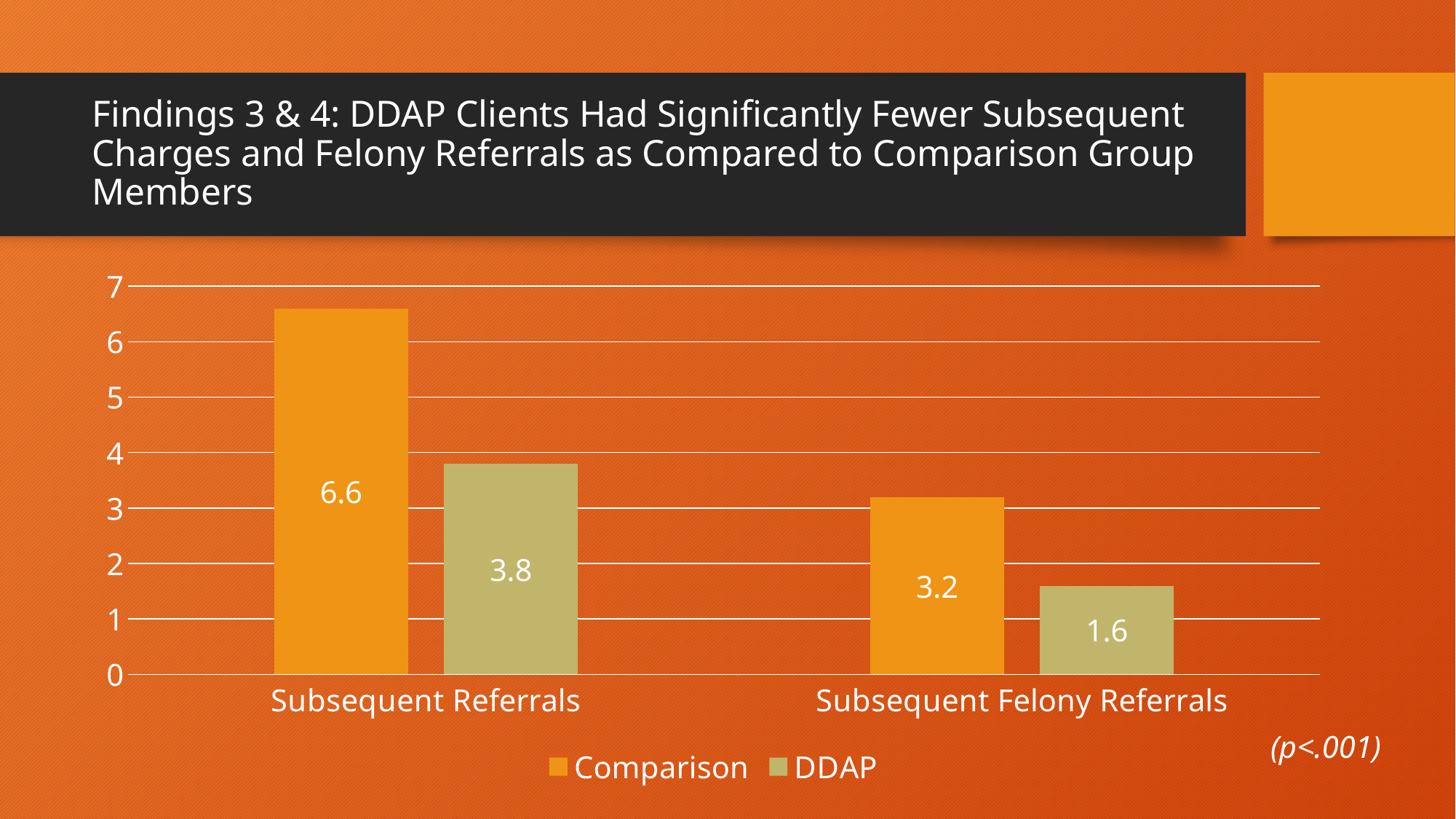
Which bar has the highest value on the chart? Comparison, Subsequent Referrals What is the Comparison group's value for Subsequent Referrals? 6.6 Which bar has the lowest value on the chart? DDAP, Subsequent Felony Referrals What kind of chart is shown on the slide? Bar chart What is the difference between the Comparison and DDAP values for Subsequent Felony Referrals? 1.6 What is the DDAP value for Subsequent Felony Referrals? 1.6 For Subsequent Felony Referrals, which group has the larger value, Comparison or DDAP? Comparison What is the difference between the Comparison and DDAP values for Subsequent Referrals? 2.8 How many series does the legend list? 2 What p-value is noted on the slide? p<.001 What is the Comparison group's value for Subsequent Felony Referrals? 3.2 What is the DDAP value for Subsequent Referrals? 3.8